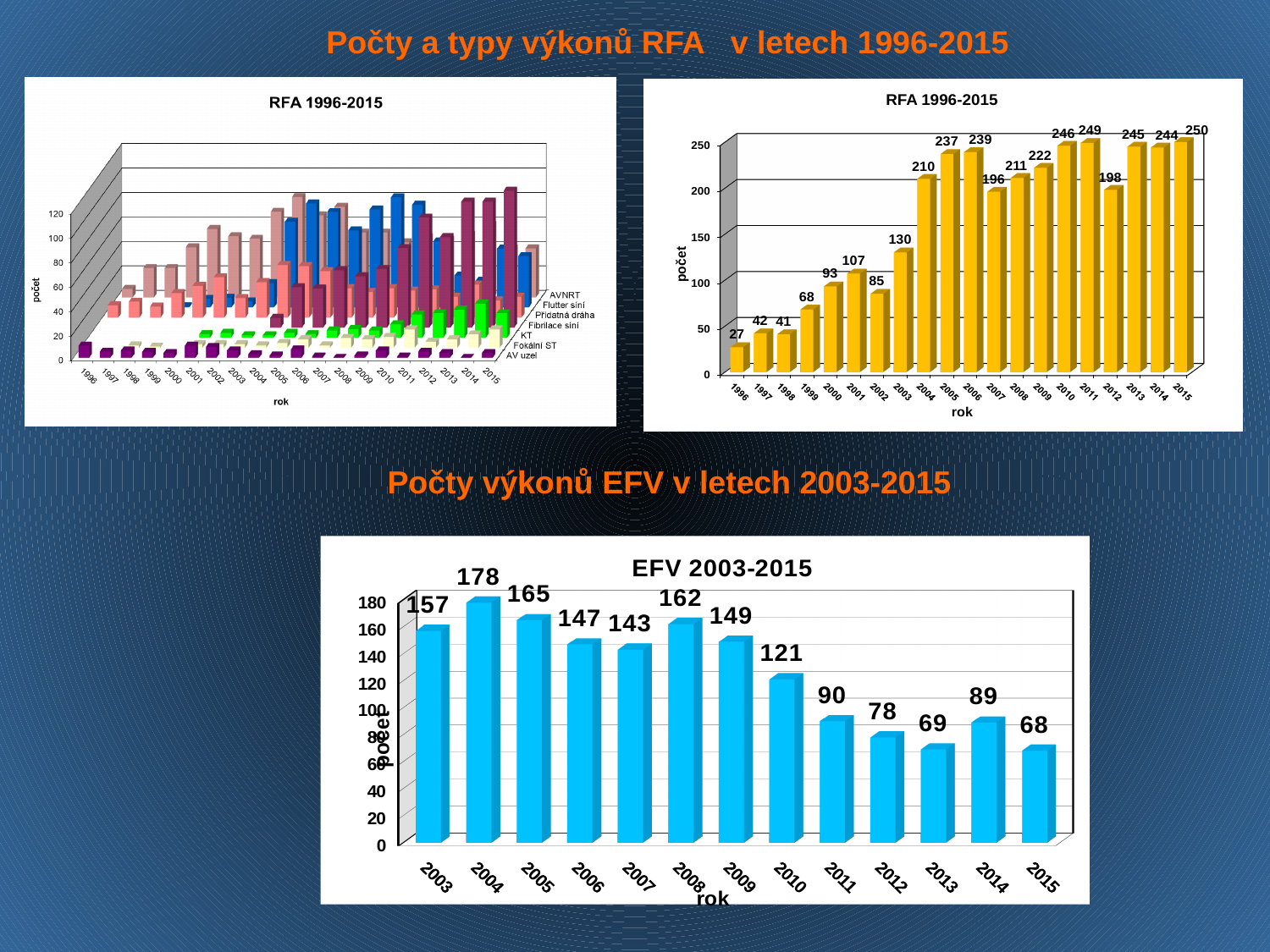
In the top-right chart titled RFA 1996-2015, which year has the lowest value? 1996 In the top-right chart titled RFA 1996-2015, which year has the highest value? 2015 In the bottom chart titled EFV 2003-2015, what is the difference between the values for 2003 and 2015? 89 In the bottom chart titled EFV 2003-2015, which year has the lowest value? 2015 In the top-right chart titled RFA 1996-2015, what is the difference between the values for 2004 and 2003? 80 How many series does the legend of the top-left chart list? 7 In the bottom chart titled EFV 2003-2015, how many years are shown on the x axis? 13 What kind of chart is the bottom chart titled EFV 2003-2015? Bar chart In the bottom chart titled EFV 2003-2015, which year has the highest value? 2004 In the top-right chart titled RFA 1996-2015, is the value for 2007 larger or smaller than the value for 2012? 2007 is smaller In the top-right chart titled RFA 1996-2015, what is the value for 2003? 130 In the bottom chart titled EFV 2003-2015, what is the value for 2004? 178